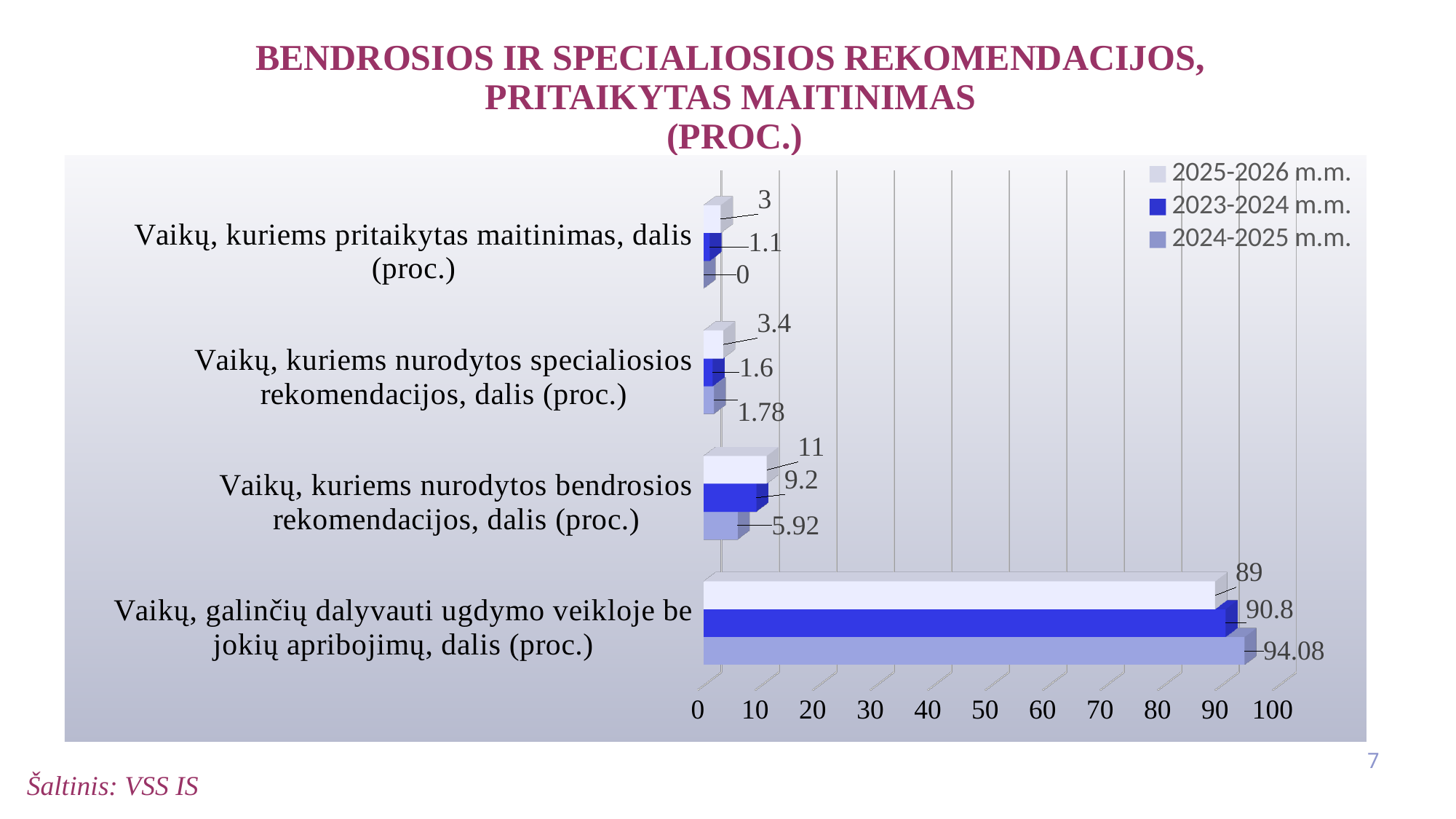
How many series does the legend list? 3 What is the value for 'Vaikų, kuriems nurodytos bendrosios rekomendacijos, dalis (proc.)' in the 2025-2026 m.m. series? 11 Which category has the highest value in the 2023-2024 m.m. series? Vaikų, galinčių dalyvauti ugdymo veikloje be jokių apribojimų, dalis (proc.) What is the value for 'Vaikų, galinčių dalyvauti ugdymo veikloje be jokių apribojimų, dalis (proc.)' in the 2024-2025 m.m. series? 94.08 What is the value for 'Vaikų, kuriems nurodytos specialiosios rekomendacijos, dalis (proc.)' in the 2024-2025 m.m. series? 1.78 What is the difference between the 2024-2025 m.m. and 2025-2026 m.m. values for 'Vaikų, galinčių dalyvauti ugdymo veikloje be jokių apribojimų, dalis (proc.)'? 5.08 For 'Vaikų, kuriems nurodytos bendrosios rekomendacijos, dalis (proc.)', which series has the larger value: 2023-2024 m.m. or 2024-2025 m.m.? 2023-2024 m.m. What kind of chart is shown on the slide? Bar chart Is the 2023-2024 m.m. value for 'Vaikų, galinčių dalyvauti ugdymo veikloje be jokių apribojimų, dalis (proc.)' greater or less than 80? greater What is the value for 'Vaikų, kuriems pritaikytas maitinimas, dalis (proc.)' in the 2023-2024 m.m. series? 1.1 How many categories are shown on the chart? 4 Which category has the lowest value in the 2024-2025 m.m. series? Vaikų, kuriems pritaikytas maitinimas, dalis (proc.)